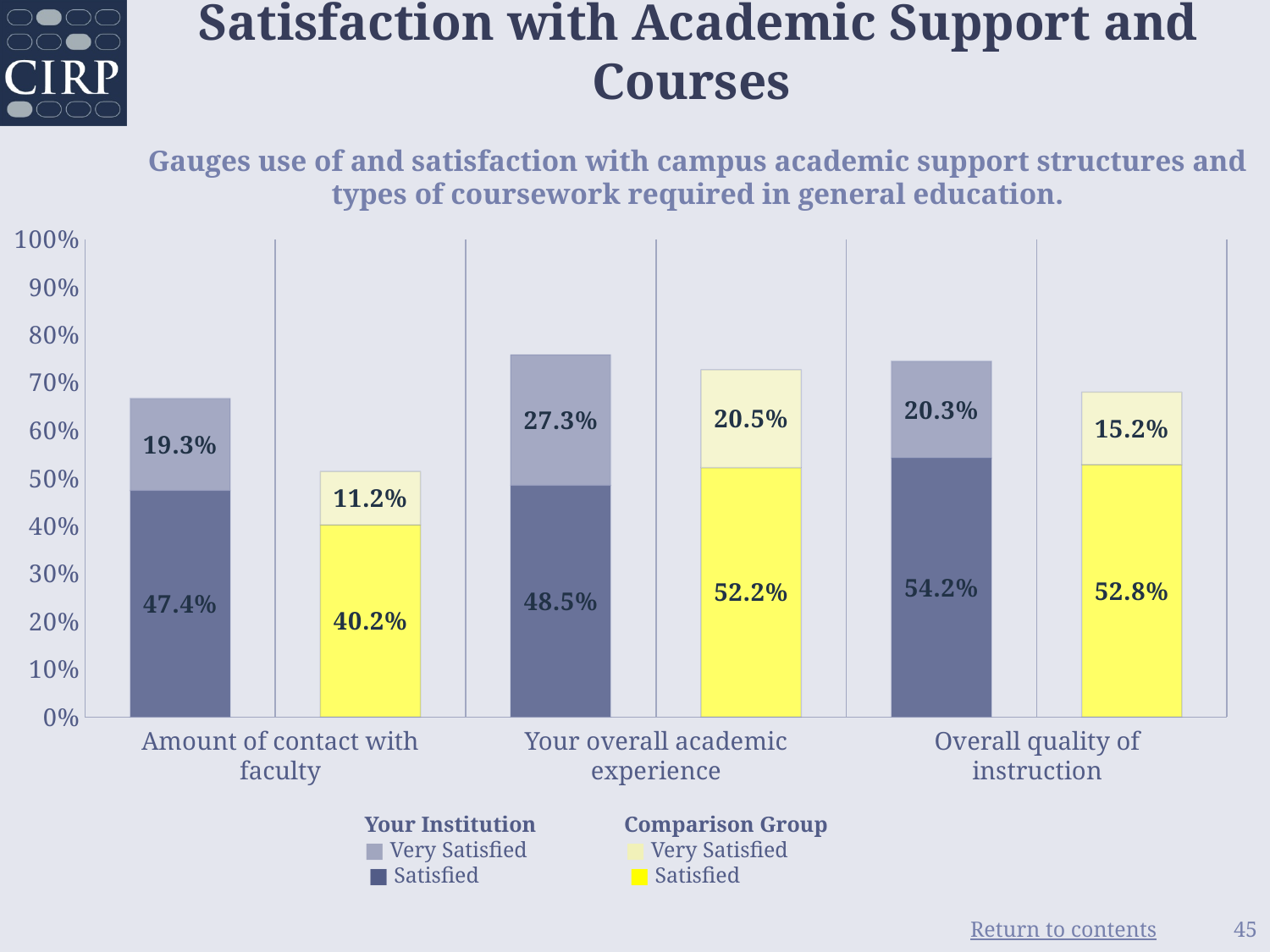
What percentage of Your Institution respondents were Satisfied with the amount of contact with faculty? 47.4% What type of chart is shown on the slide? Stacked bar chart Which category has the lowest Satisfied percentage for the Comparison Group? Amount of contact with faculty What percentage of Your Institution respondents were Very Satisfied with their overall academic experience? 27.3% How many series does the legend list? 4 What percentage of the Comparison Group were Very Satisfied with the overall quality of instruction? 15.2% For overall quality of instruction, which group has the larger Satisfied percentage, Your Institution or the Comparison Group? Your Institution What is the combined Satisfied and Very Satisfied total for Your Institution on overall quality of instruction? 74.5% What is the difference between the Your Institution and Comparison Group Very Satisfied percentages for amount of contact with faculty? 8.1% How many categories are shown on the x axis of the chart? 3 What is the combined Satisfied and Very Satisfied total for the Comparison Group on amount of contact with faculty? 51.4% Across the three categories, which has the highest Very Satisfied percentage for Your Institution? Your overall academic experience